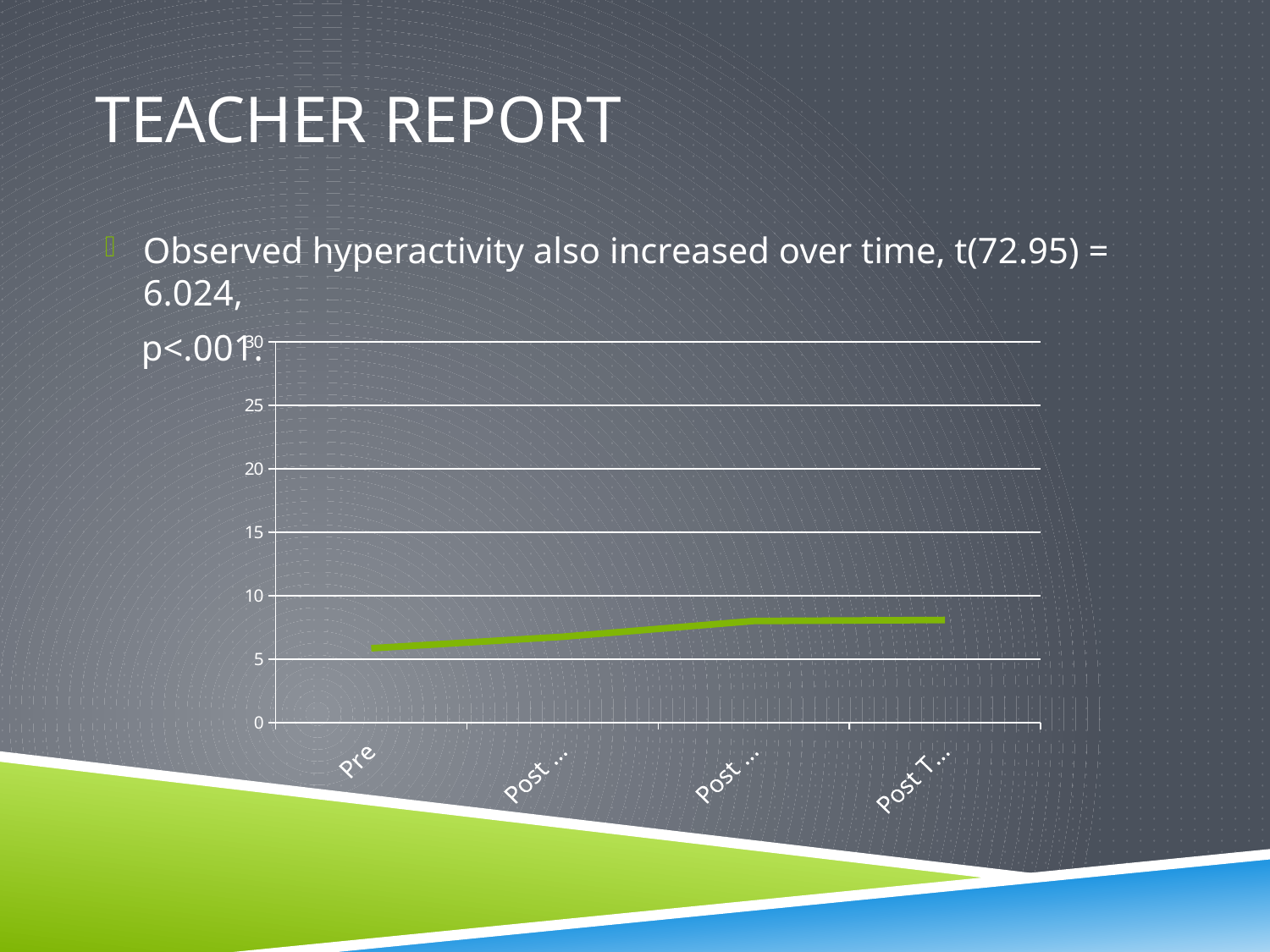
Which is larger, the value for Pre or the value at the last point on the x axis? the last point Is the value at the last point on the x axis greater or less than 10? less Which point on the x axis has the lowest value? Pre Is the value at the last point on the x axis greater or less than 5? greater How many data points are plotted on the line? 4 Is the value for Pre greater or less than 5? greater What is the label of the first category on the x axis? Pre What kind of chart is shown on the slide? line chart What is the highest value shown on the y axis? 30 Do the values rise or fall from the Pre point to the last point on the x axis? rise